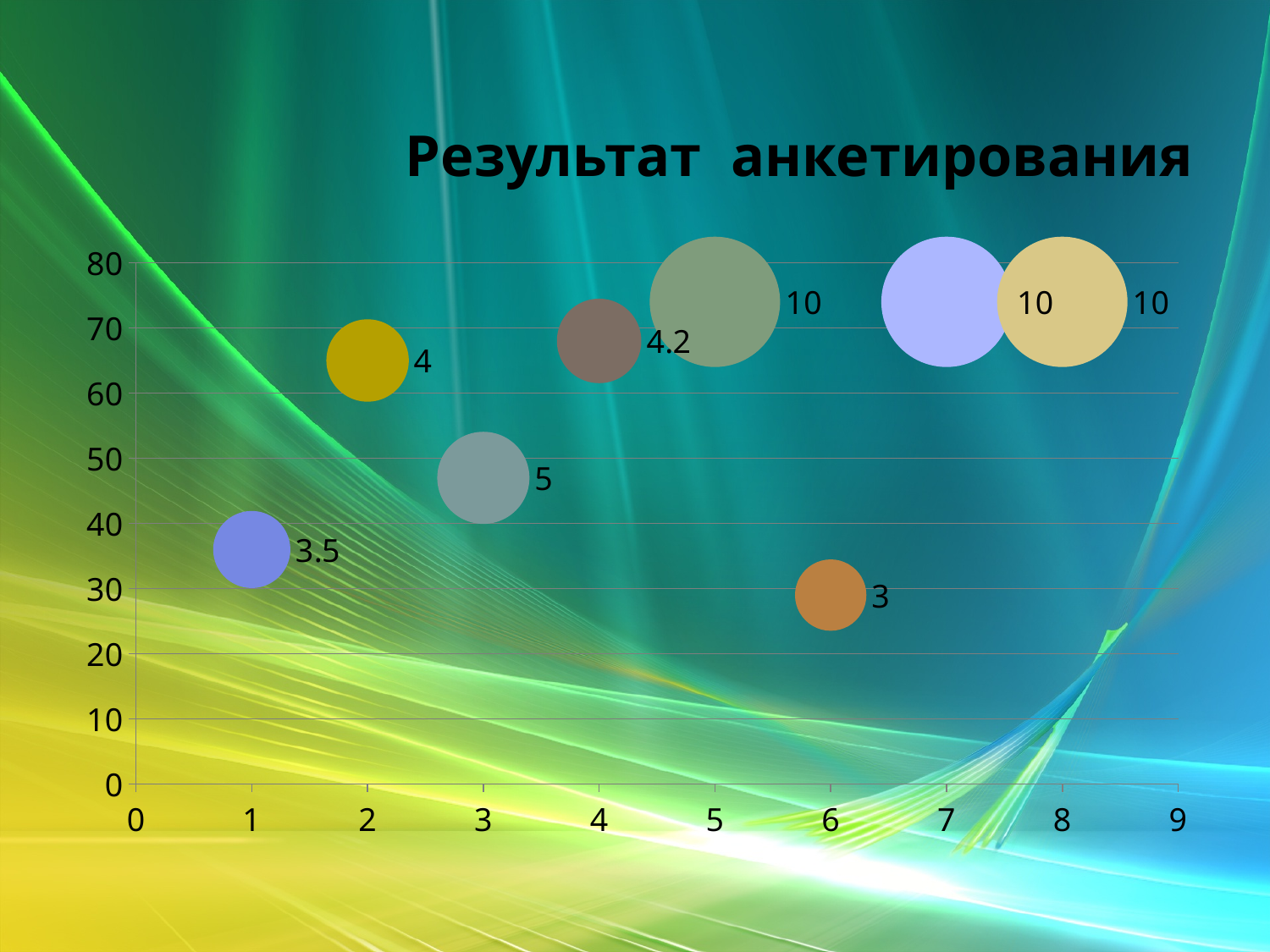
Which bubble has the smallest data label? the bubble at x = 6 (3) What is the difference between the data labels of the bubble at x = 5 and the bubble at x = 6? 7 What kind of chart is shown on the slide? bubble chart Is the vertical position of the bubble at x = 6 greater or less than 40? less Is the vertical position of the bubble at x = 2 greater or less than 60? greater How many bubbles are plotted on the chart? 8 What is the data label of the bubble at x = 6? 3 What is the data label of the bubble at x = 4? 4.2 Which has the larger data label: the bubble at x = 3 or the bubble at x = 4? the bubble at x = 3 (5) What is the title of the chart? Результат анкетирования What is the data label of the bubble at x = 3? 5 What is the data label of the bubble at x = 1? 3.5